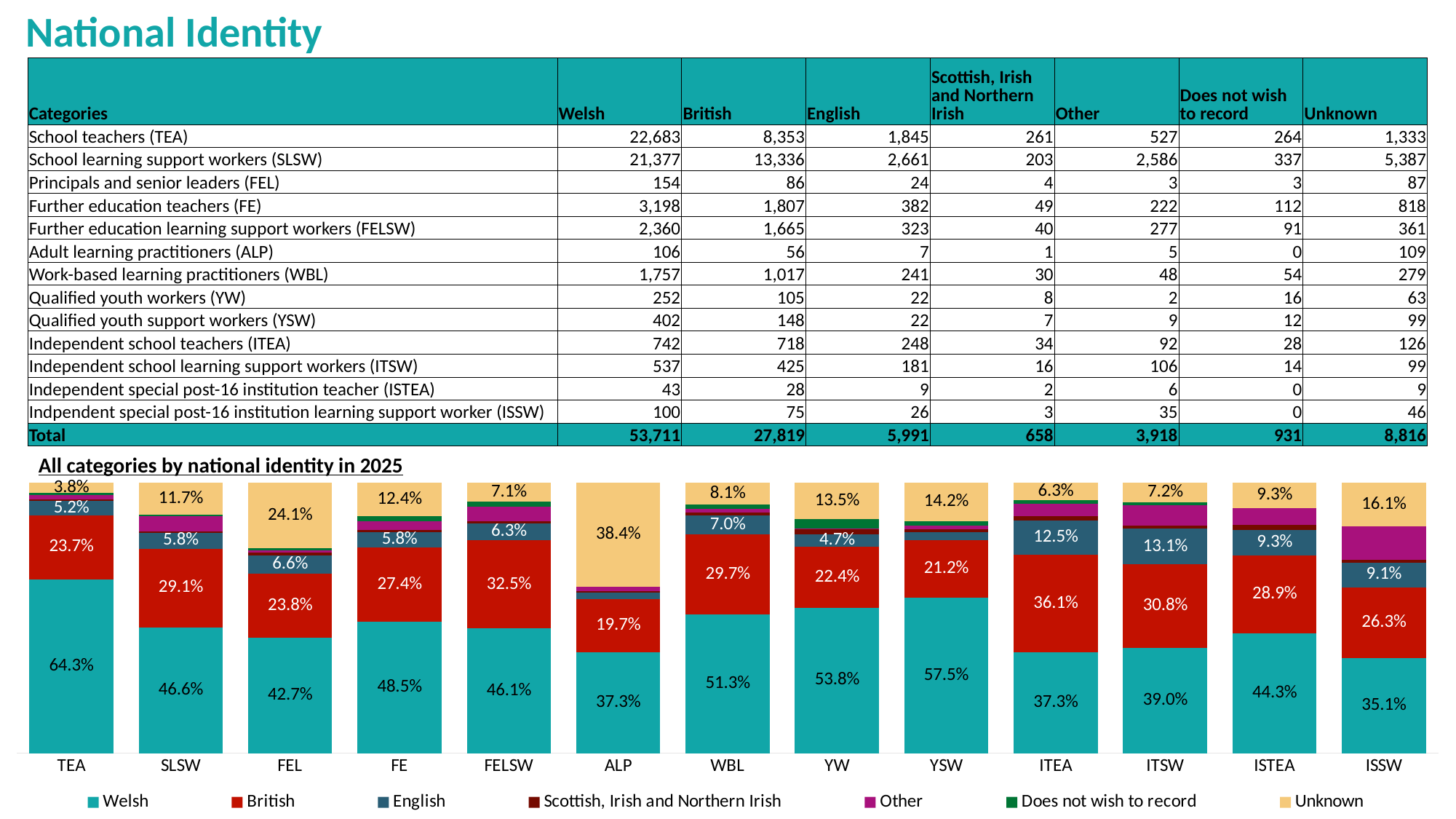
Which category has the highest Welsh share in the chart? TEA In the chart, what is the British share for FELSW? 32.5% How many series does the chart's legend list? 7 What kind of chart is shown under the title 'All categories by national identity in 2025'? Stacked bar chart In the chart, what is the difference between the Welsh share for TEA and the Welsh share for ISSW? 29.2 percentage points Which category has the highest British share in the chart? ITEA In the chart, what is the Welsh share for TEA? 64.3% In the chart, what is the Unknown share for ALP? 38.4% How many categories are shown along the x axis of the chart? 13 In the chart, which is larger: the Unknown share for FEL or the Unknown share for SLSW? FEL In the chart, what is the English share for ITSW? 13.1% Which category has the lowest Welsh share in the chart? ISSW